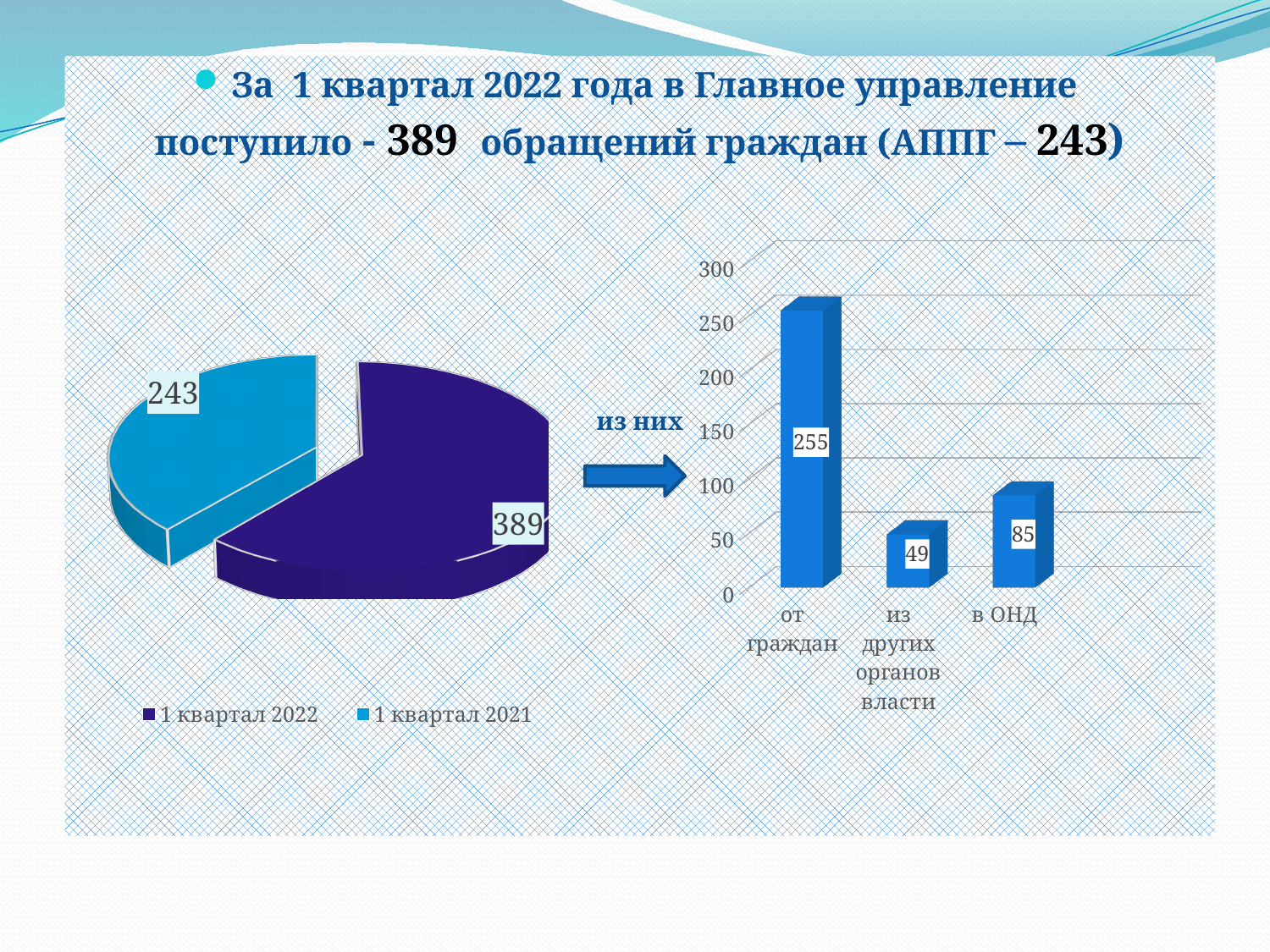
In the pie chart on the left, what is the value for 1 квартал 2021? 243 In the bar chart on the right, what is the value for в ОНД? 85 In the bar chart on the right, what is the difference between the values for от граждан and в ОНД? 170 In the pie chart on the left, what is the value for 1 квартал 2022? 389 In the bar chart on the right, what is the value for из других органов власти? 49 In the pie chart on the left, which slice is larger, 1 квартал 2022 or 1 квартал 2021? 1 квартал 2022 In the bar chart on the right, which category has the lowest value? из других органов власти What kind of chart is the chart on the left of the slide? Pie chart In the bar chart on the right, what is the value for от граждан? 255 How many entries does the legend of the pie chart on the left list? 2 In the pie chart on the left, what is the difference between the values for 1 квартал 2022 and 1 квартал 2021? 146 How many categories are shown in the bar chart on the right? 3